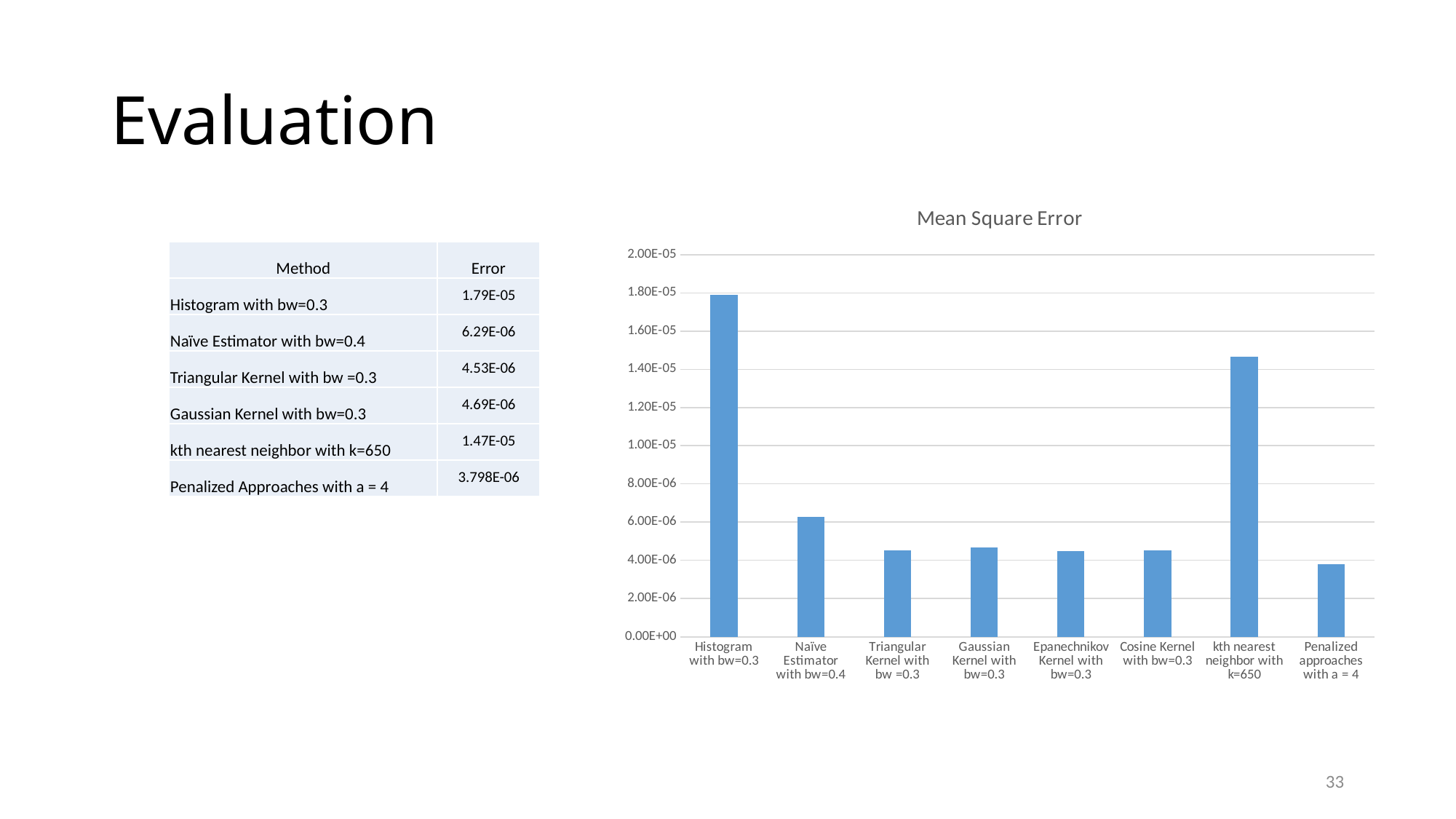
What kind of chart is shown on the slide? bar chart Is the mean square error for kth nearest neighbor with k=650 greater or less than 1.20E-05? greater Which method has the lowest mean square error in the chart? Penalized approaches with a = 4 Which has the larger mean square error, Histogram with bw=0.3 or kth nearest neighbor with k=650? Histogram with bw=0.3 Which has the larger mean square error, Naïve Estimator with bw=0.4 or Triangular Kernel with bw =0.3? Naïve Estimator with bw=0.4 Is the mean square error for Histogram with bw=0.3 greater or less than 1.60E-05? greater Is the mean square error for Naïve Estimator with bw=0.4 greater or less than 8.00E-06? less Which method has the highest mean square error in the chart? Histogram with bw=0.3 How many methods (categories) are plotted in the Mean Square Error chart? 8 What is the title of the chart? Mean Square Error